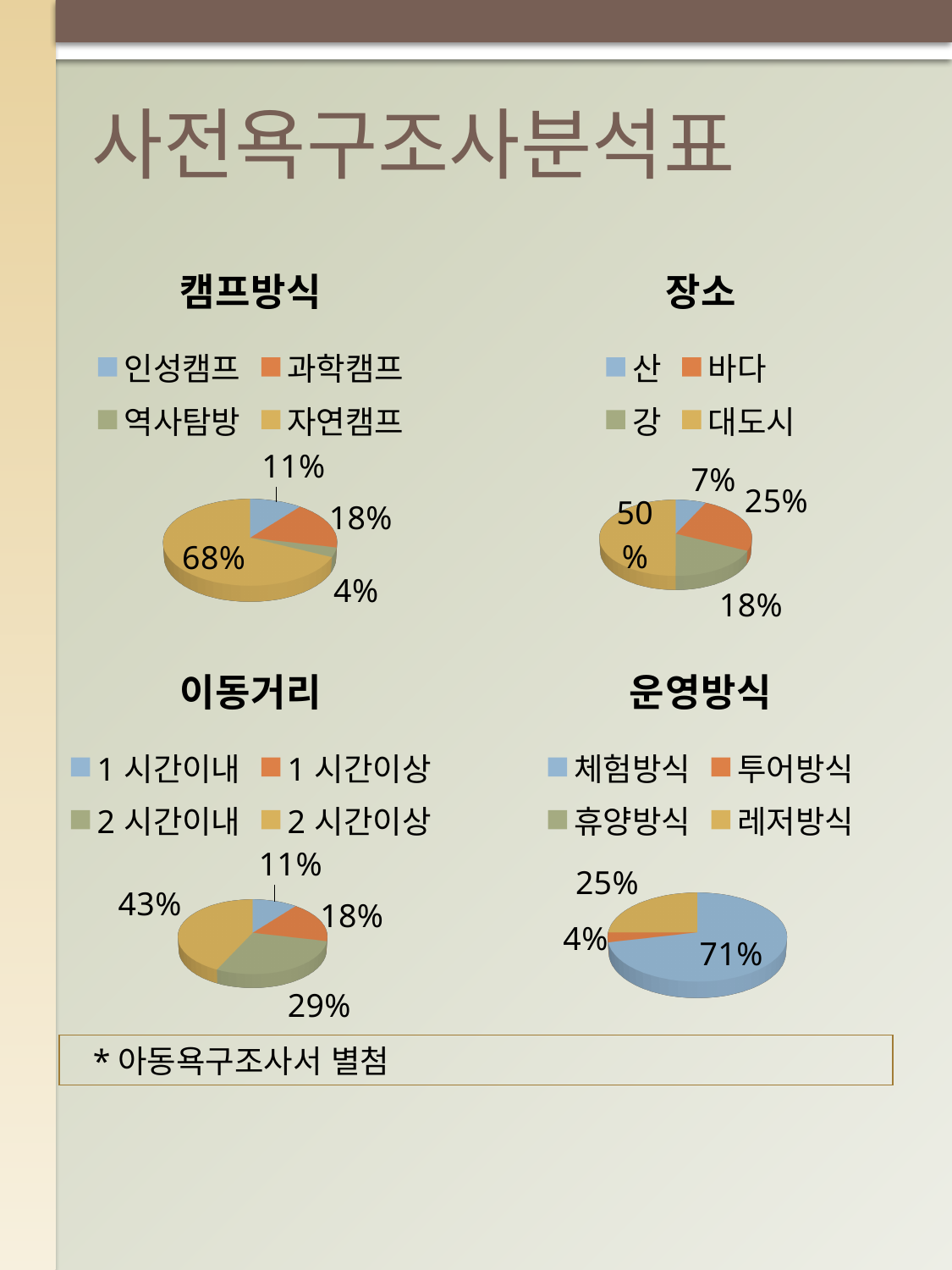
In the 장소 chart, which is larger, 바다 or 강? 바다 In the 이동거리 chart, what is the difference between 2 시간이내 and 1 시간이상? 11% In the 장소 chart, what percentage is 대도시? 50% In the 운영방식 chart, what percentage is 체험방식? 71% What type of chart is the 이동거리 chart? Pie chart In the 장소 chart, which category has the largest share? 대도시 In the 캠프방식 chart, what percentage is 자연캠프? 68% In the 이동거리 chart, what percentage is 2 시간이상? 43% In the 캠프방식 chart, which category has the smallest share? 역사탐방 In the 캠프방식 chart, what is the difference between 과학캠프 and 인성캠프? 7% In the 운영방식 chart, which category has the largest share? 체험방식 In the 장소 chart, what percentage is 산? 7%